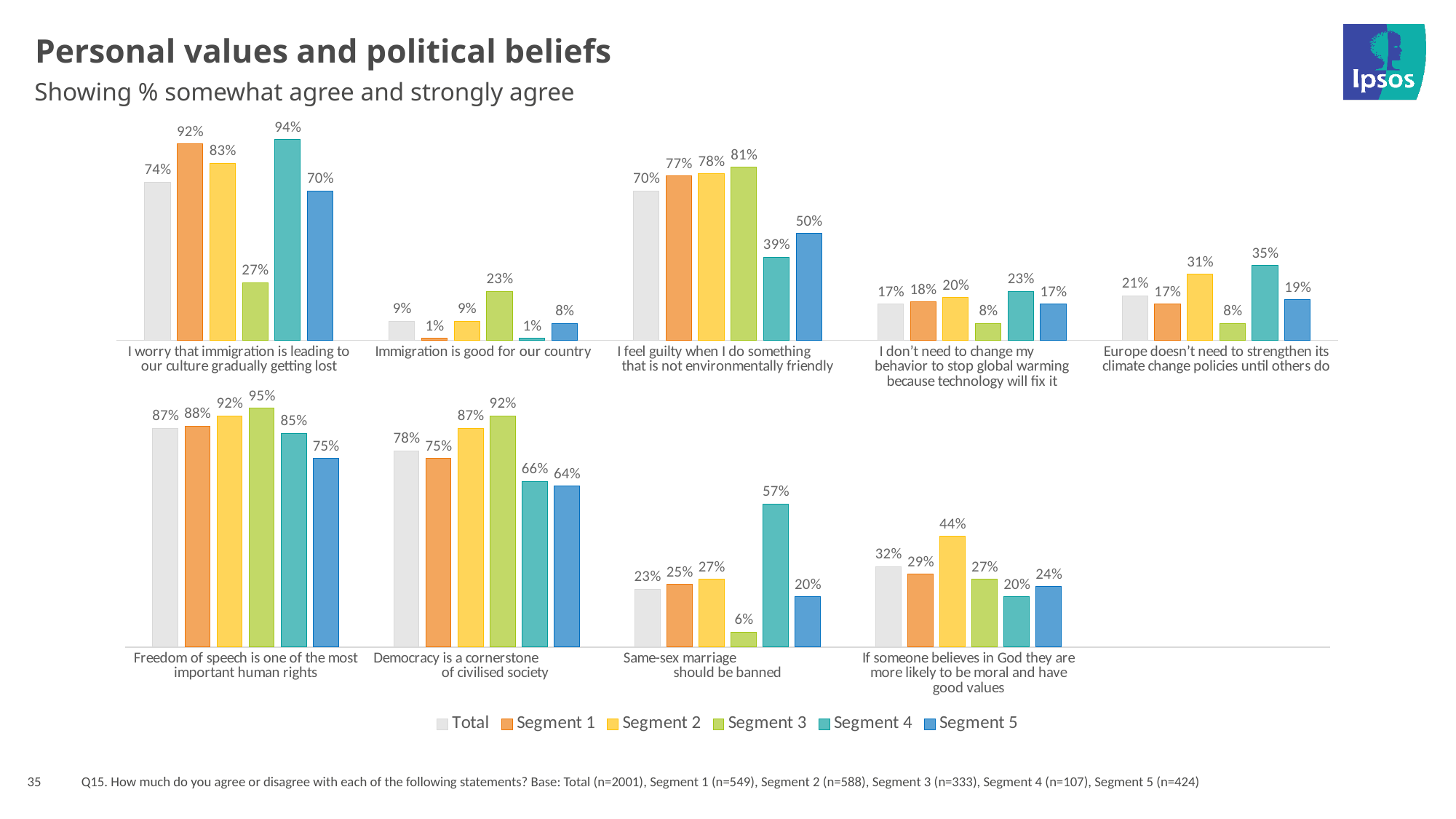
How many series does the legend list? 6 In the bottom chart, which segment has the highest value for "Same-sex marriage should be banned"? Segment 4 In the bottom chart, what is the difference between the Segment 3 and Segment 5 values for "Freedom of speech is one of the most important human rights"? 20% In the top chart, what is the Total value for "I feel guilty when I do something that is not environmentally friendly"? 70% In the bottom chart, what is the Segment 1 value for "Democracy is a cornerstone of civilised society"? 75% In the bottom chart, what is the Segment 2 value for "If someone believes in God they are more likely to be moral and have good values"? 44% What is the subtitle of the slide? Showing % somewhat agree and strongly agree In the top chart, what is the Segment 4 value for "I worry that immigration is leading to our culture gradually getting lost"? 94% What type of chart is used on this slide? Bar chart How many statements (categories) are shown in the bottom chart? 4 In the top chart, which is larger for "Immigration is good for our country": the Segment 3 value or the Segment 5 value? Segment 3 In the top chart, which segment has the lowest value for "Europe doesn't need to strengthen its climate change policies until others do"? Segment 3